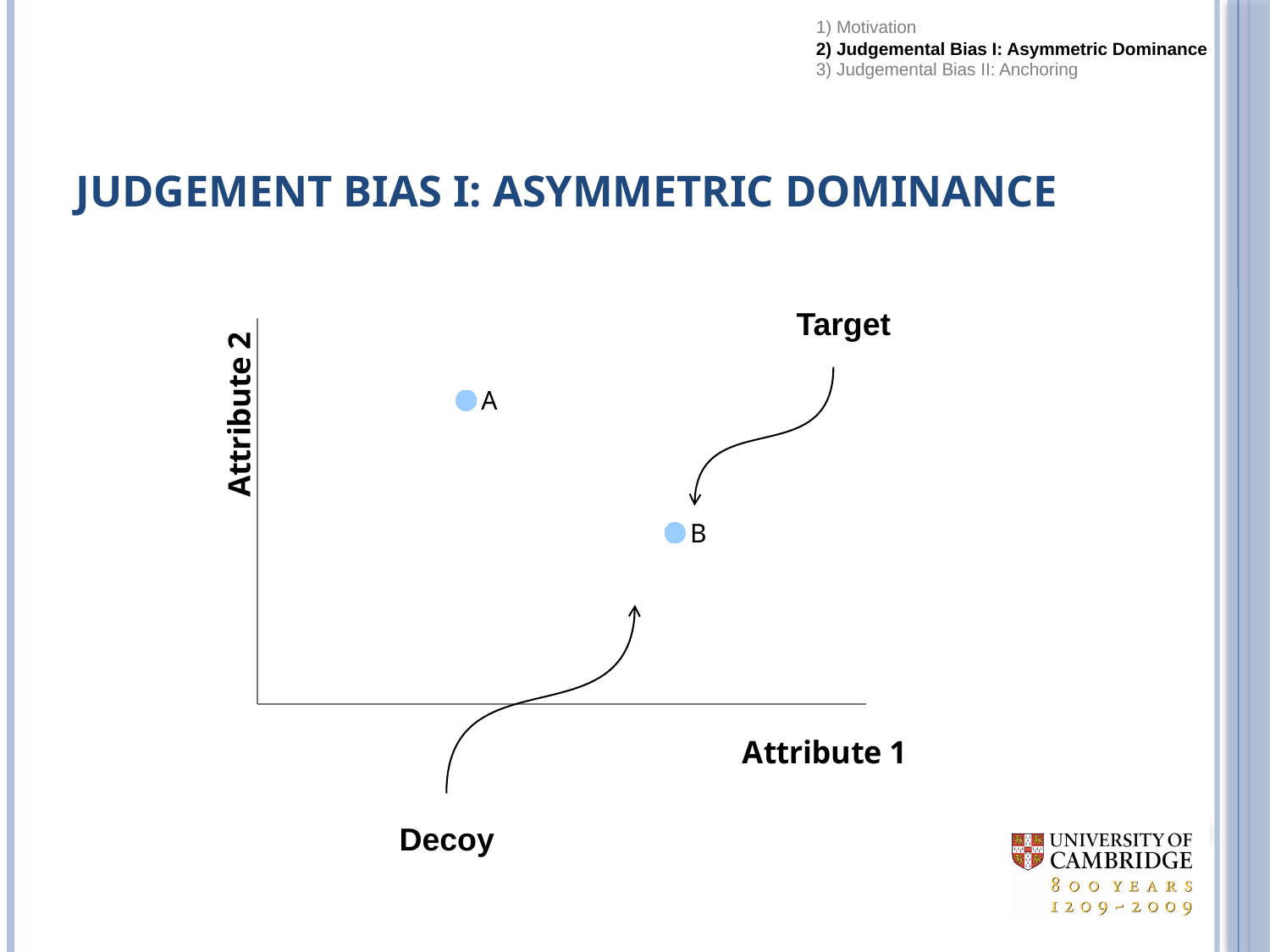
Which point has the higher value on Attribute 2, A or B? A Which point is positioned highest on the Attribute 2 axis? A What is the label of the horizontal axis? Attribute 1 What is the label of the vertical axis? Attribute 2 How many data points are plotted on the chart? 2 Which point is positioned furthest to the right on the Attribute 1 axis? B Which point has the higher value on Attribute 1, A or B? B Which plotted point does the arrow labelled "Target" point to? B Which point is positioned furthest to the left on the Attribute 1 axis? A What kind of chart is shown on the slide? Scatter plot Which point is positioned lowest on the Attribute 2 axis? B